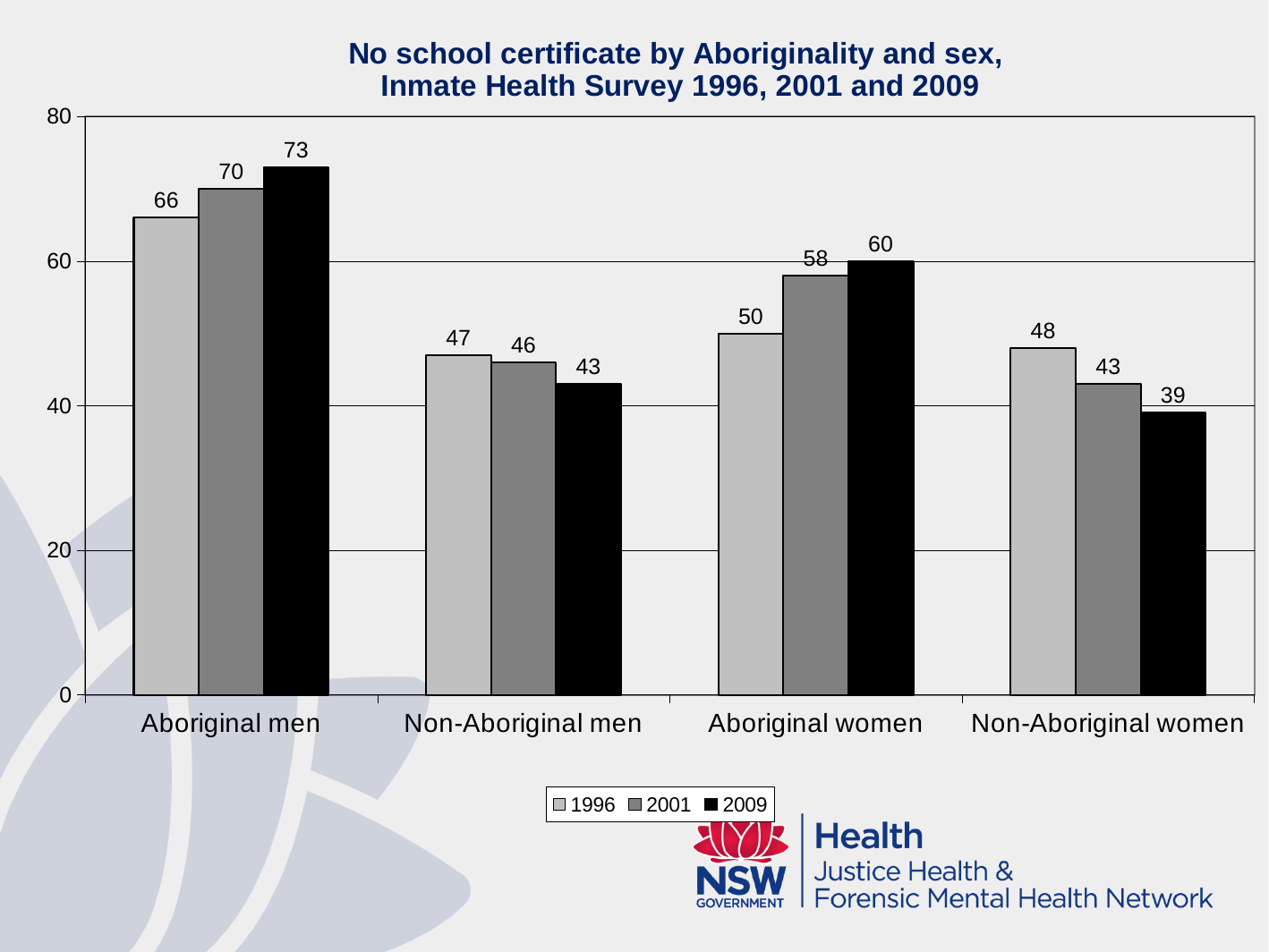
How many series does the legend list? 3 What kind of chart is shown on the slide? Bar chart Do the values for Non-Aboriginal women rise or fall from 1996 to 2009? Fall What is the difference between the 2009 and 1996 values for Aboriginal women? 10 Which category has the highest value in 2009? Aboriginal men How many categories are shown on the x axis? 4 What is the value for Aboriginal women in 2001? 58 Which is larger: the 2001 value for Non-Aboriginal men or the 2001 value for Non-Aboriginal women? Non-Aboriginal men What is the value for Non-Aboriginal women in 1996? 48 Which category has the lowest value in 2009? Non-Aboriginal women What is the value for Aboriginal men in 2009? 73 Is the 1996 value for Aboriginal men greater or less than 60? greater